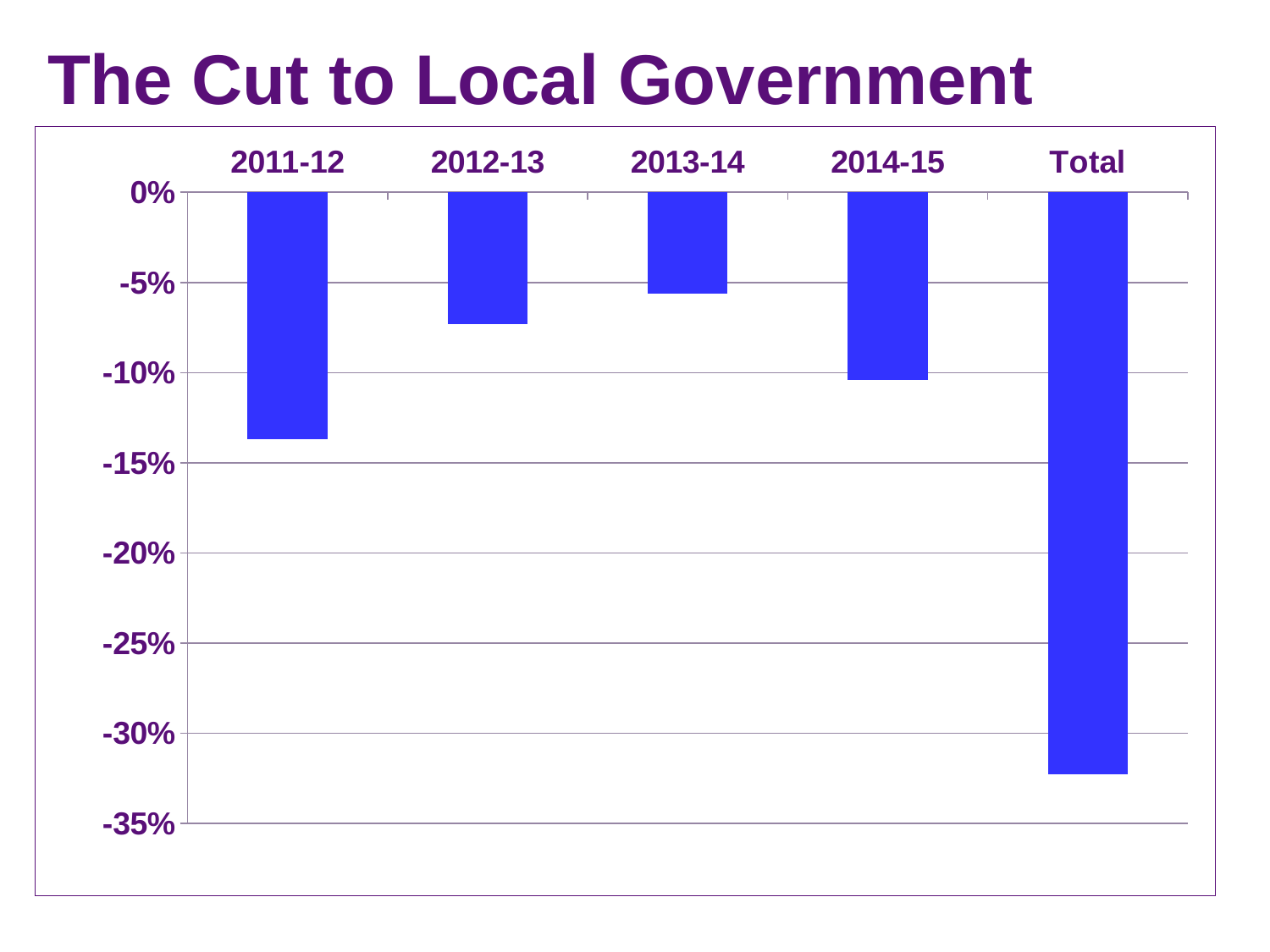
Which category has the lowest value in the chart? Total Is the value for Total greater or less than -30%? less What is the title of the slide? The Cut to Local Government How many bars are plotted in the chart? 5 Is the value for 2012-13 greater or less than -10%? greater Among the four individual years (excluding Total), which year shows the largest cut? 2011-12 Among the four individual years (excluding Total), which year shows the smallest cut? 2013-14 Which category has the value closest to 0%? 2013-14 What kind of chart is shown on the slide? bar chart What colour are the bars in the chart? blue Which bar is lower, 2012-13 or 2014-15? 2014-15 Is the value for 2011-12 greater or less than -10%? less